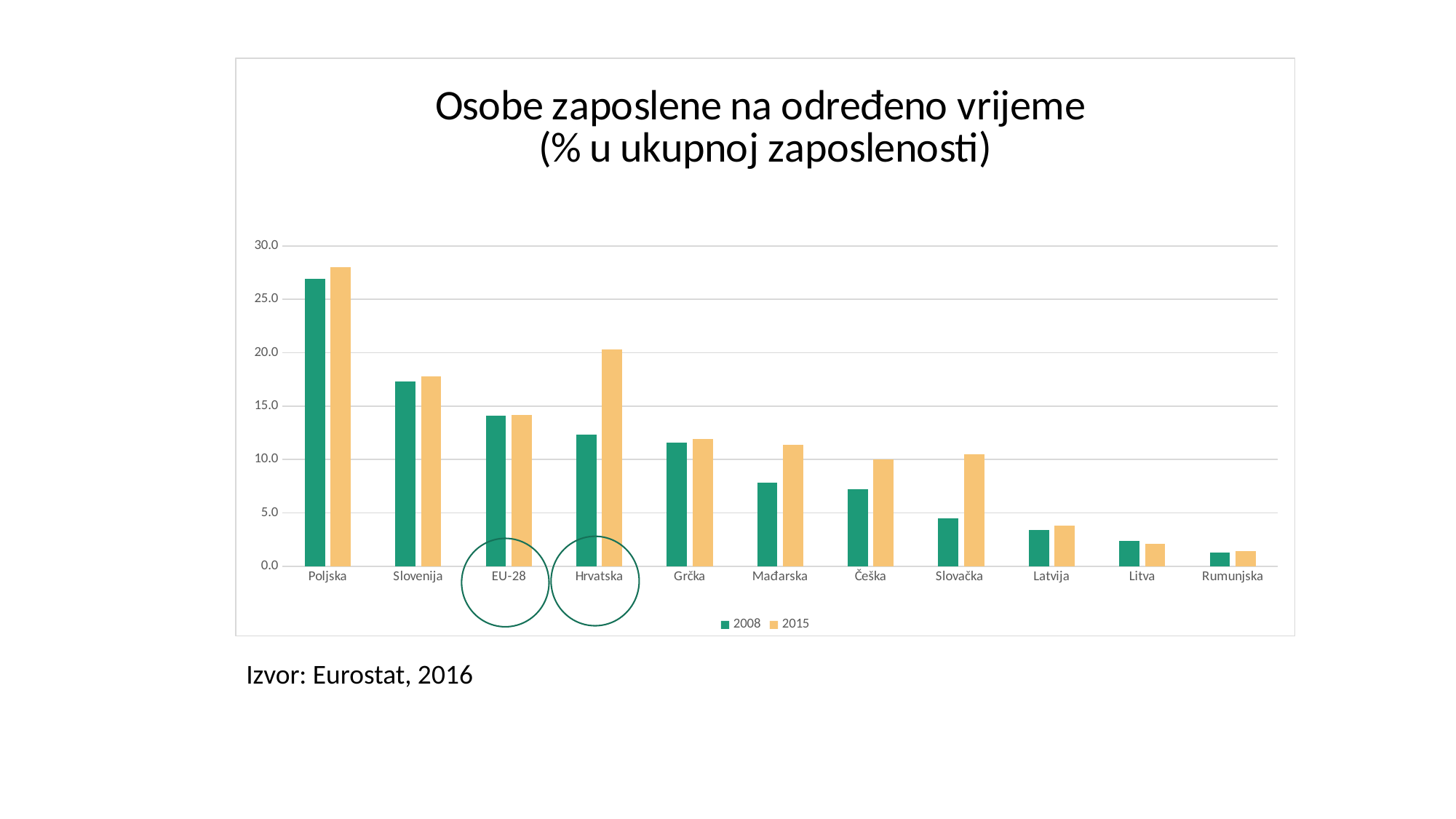
Is the 2008 value for Hrvatska greater or less than 10.0? greater How many series does the legend list? 2 What kind of chart is shown on the slide? bar chart Is the 2008 value for Mađarska greater or less than 10.0? less Which two years are listed in the chart legend? 2008 and 2015 How many countries/regions are shown on the x axis of the chart? 11 Which category has the lowest value for 2008? Rumunjska For Hrvatska, which year has the larger value, 2008 or 2015? 2015 Which is larger: the 2015 value for Hrvatska or the 2015 value for Slovenija? Hrvatska Is the 2015 value for Poljska greater or less than 25.0? greater Which category has the highest value for 2015? Poljska